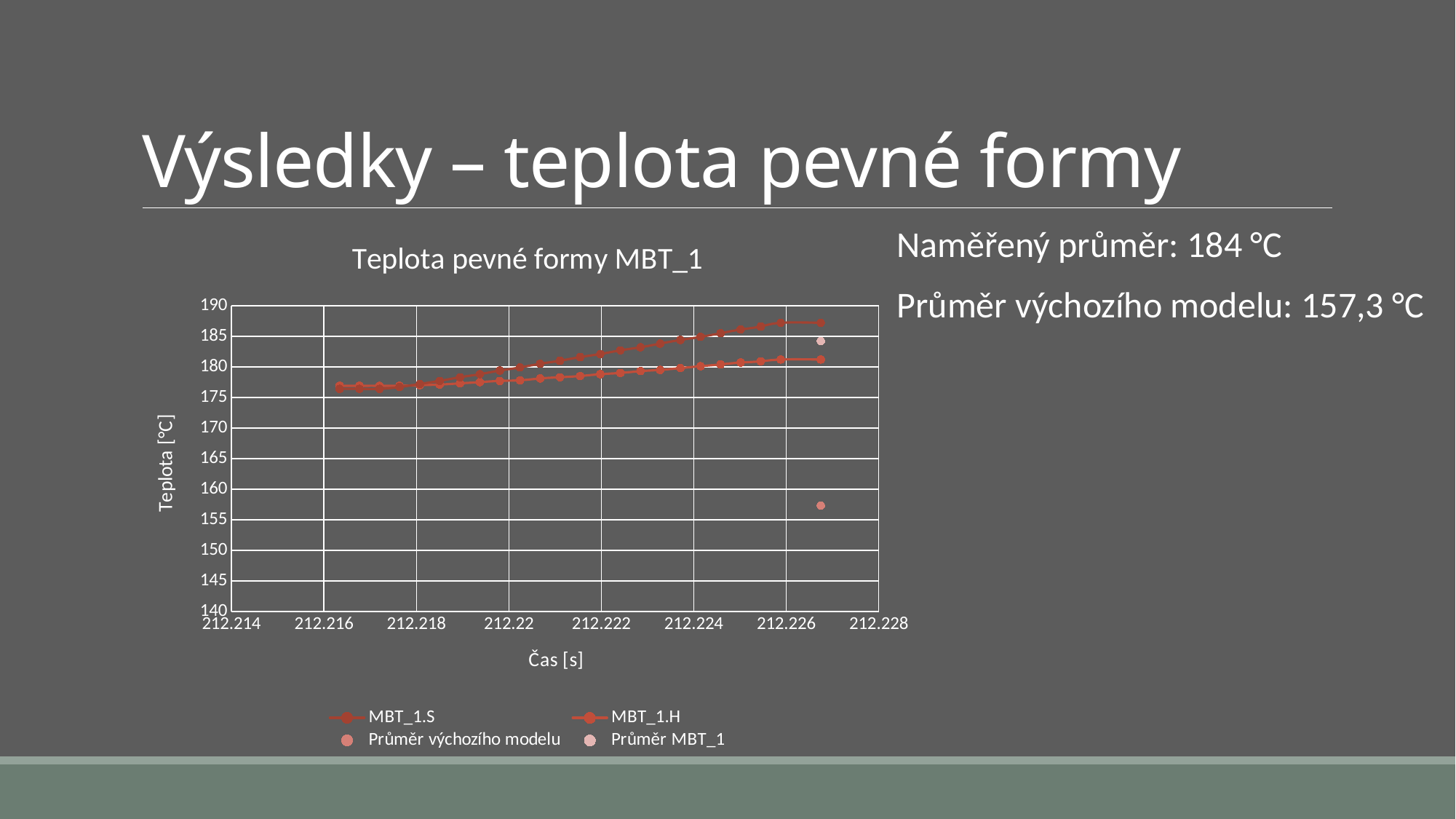
Do the values of the MBT_1.S series rise or fall along the x axis? rise Which is larger, the Průměr MBT_1 point or the Průměr výchozího modelu point? Průměr MBT_1 Is the final value of the lower line (at about 212.2268) greater or less than 185? less Is the value of the Průměr MBT_1 point greater or less than 180? greater Are the starting values of both lines (at about 212.216) greater or less than 175? greater What is the title of the chart? Teplota pevné formy MBT_1 Do the values of the MBT_1.H series rise or fall along the x axis? rise How many series does the chart legend list? 4 What kind of chart is shown on the slide? line chart What is the label of the y axis of the chart? Teplota [°C]